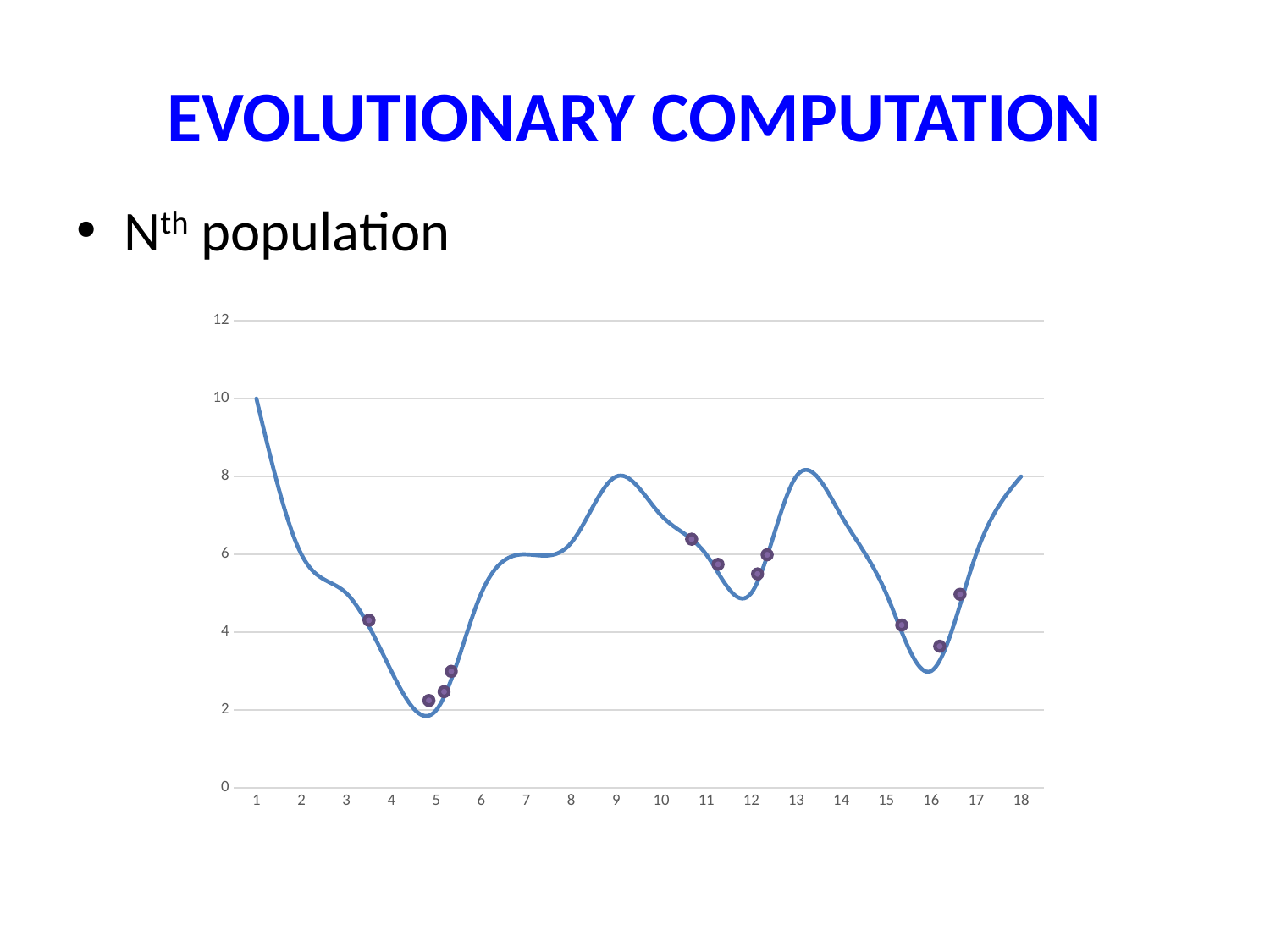
Is the value of the line at x = 13 greater or less than 6? greater How many categories are labelled on the x axis of the chart? 18 Does the line rise or fall between x = 1 and x = 4? fall At which x-axis label does the line reach its highest value? 1 What is the highest value shown on the y axis of the chart? 12 Is the value of the line at x = 9 greater or less than 6? greater What is the value of the line at x = 1? 10 What kind of chart is shown on the slide? line chart Is the value of the line at x = 5 greater or less than 4? less What is the value of the line at x = 18? 8 Does the line rise or fall between x = 5 and x = 9? rise